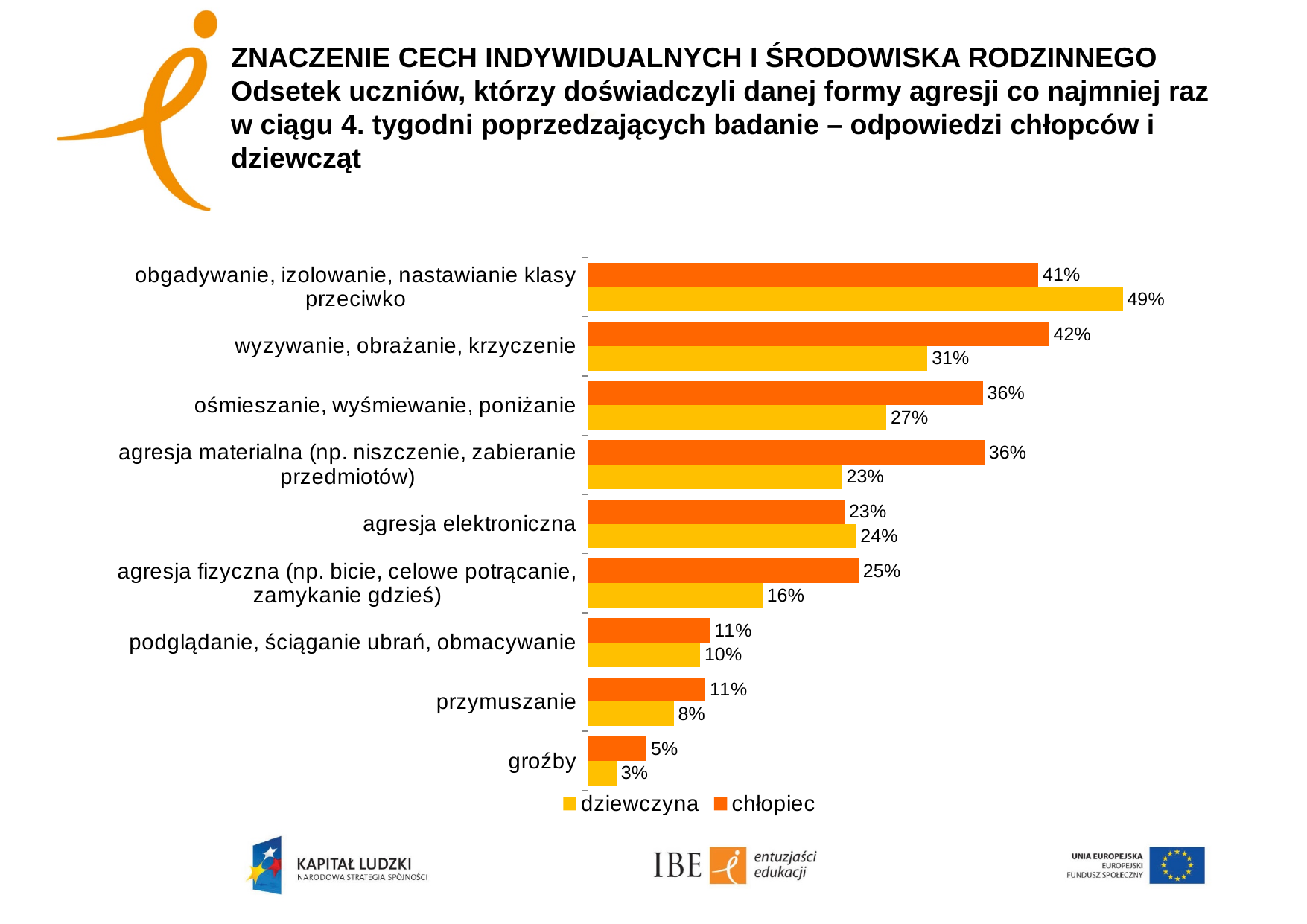
Which category has the highest value for the 'dziewczyna' series? obgadywanie, izolowanie, nastawianie klasy przeciwko What type of chart is shown on the slide? bar chart What is the difference between the 'chłopiec' and 'dziewczyna' values for 'agresja materialna (np. niszczenie, zabieranie przedmiotów)'? 13 percentage points Which colour represents the 'chłopiec' series? orange What is the value for 'dziewczyna' in the 'agresja elektroniczna' category? 24% What percentage of girls (dziewczyna) experienced 'wyzywanie, obrażanie, krzyczenie'? 31% How many categories are shown on the chart? 9 How many series does the legend list? 2 What percentage of boys (chłopiec) experienced 'agresja fizyczna (np. bicie, celowe potrącanie, zamykanie gdzieś)'? 25% Which category has the lowest value for the 'dziewczyna' series? groźby For 'obgadywanie, izolowanie, nastawianie klasy przeciwko', which series has the larger value, 'dziewczyna' or 'chłopiec'? dziewczyna Which category has the highest value for the 'chłopiec' series? wyzywanie, obrażanie, krzyczenie